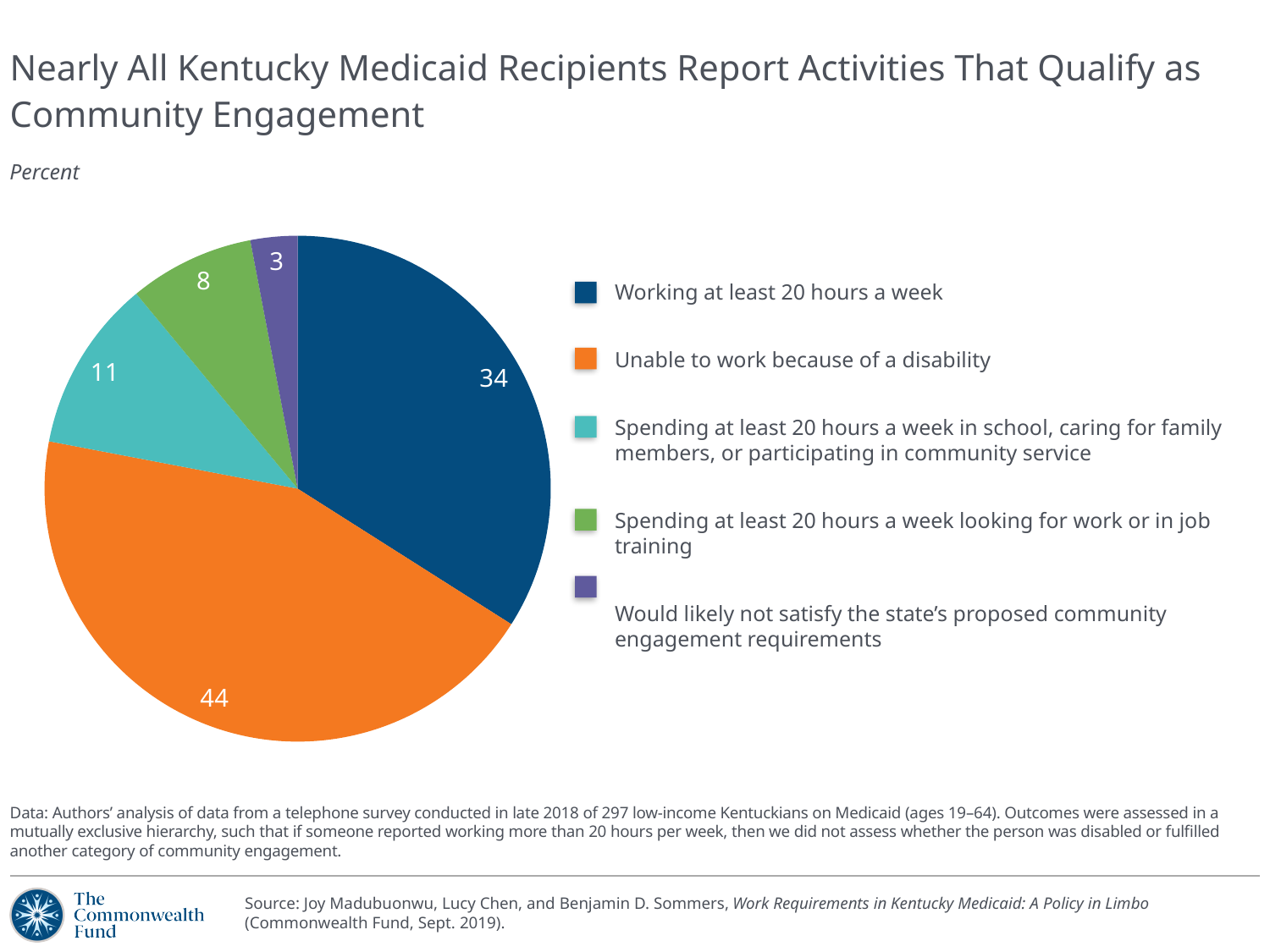
What is the value for 'Would likely not satisfy the state's proposed community engagement requirements'? 3 Which category has the largest slice of the pie? Unable to work because of a disability What is the value for 'Unable to work because of a disability'? 44 What share of the pie does 'Working at least 20 hours a week' represent? 34% What kind of chart is shown on the slide? pie chart What is the value for 'Spending at least 20 hours a week looking for work or in job training'? 8 What is the value for 'Working at least 20 hours a week'? 34 How many categories does the pie chart show? 5 What is the value for 'Spending at least 20 hours a week in school, caring for family members, or participating in community service'? 11 What is the difference between the value for 'Unable to work because of a disability' and the value for 'Working at least 20 hours a week'? 10 Which is larger: the value for 'Spending at least 20 hours a week in school, caring for family members, or participating in community service' or the value for 'Spending at least 20 hours a week looking for work or in job training'? Spending at least 20 hours a week in school, caring for family members, or participating in community service Which category has the smallest slice of the pie? Would likely not satisfy the state's proposed community engagement requirements